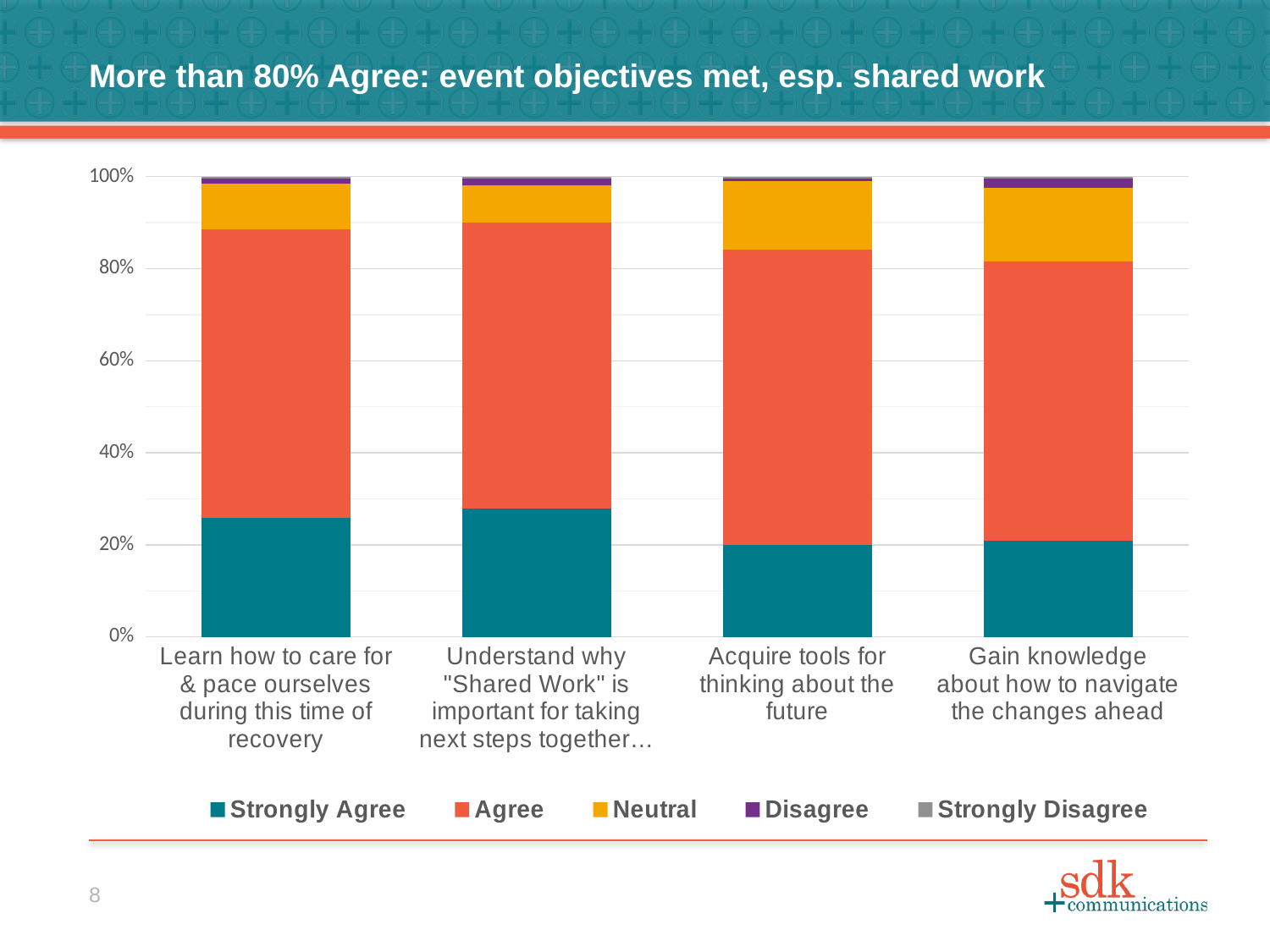
Is the Strongly Agree value for "Understand why "Shared Work" is important for taking next steps together…" greater or less than 40%? less How many series does the legend list? 5 What is the title of the slide containing the chart? More than 80% Agree: event objectives met, esp. shared work Which legend entry is shown in orange-red? Agree Which category has the largest Strongly Agree segment? Understand why "Shared Work" is important for taking next steps together… How many categories (event objectives) are shown along the x axis? 4 Is the Neutral segment for "Gain knowledge about how to navigate the changes ahead" greater or less than 20%? less What kind of chart is shown on the slide? Stacked bar chart Is the Strongly Agree value for "Learn how to care for & pace ourselves during this time of recovery" greater or less than 20%? greater Is the Strongly Agree segment larger for "Understand why "Shared Work" is important for taking next steps together…" or for "Acquire tools for thinking about the future"? Understand why "Shared Work" is important for taking next steps together… What does each stacked bar total, as shown by the top of the y axis? 100%